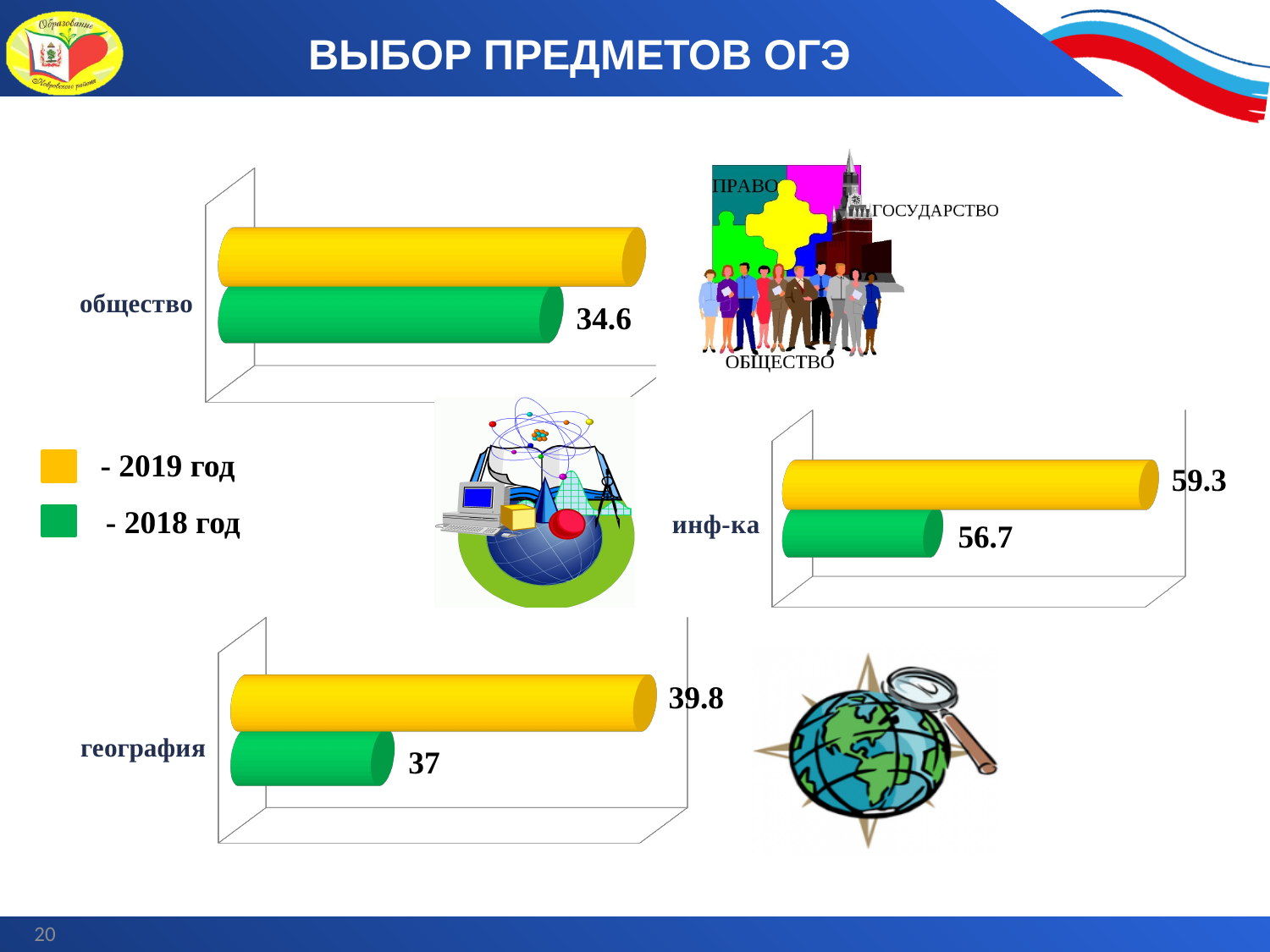
In the chart for общество, which year has the longer bar, 2019 or 2018? 2019 In the chart for география, which year has the larger value, 2019 or 2018? 2019 In the chart for инф-ка, what is the value for 2019? 59.3 In the chart for инф-ка, what is the difference between the 2019 and 2018 values? 2.6 What kind of chart is used for the subjects on this slide? Bar chart How many years does the legend list? 2 In the chart for география, what is the value for 2018? 37 In the chart for общество, what is the value for 2018? 34.6 In the chart for география, what is the value for 2019? 39.8 In the chart for география, what is the difference between the 2019 and 2018 values? 2.8 Which colour represents 2018 in the legend? Green In the chart for инф-ка, what is the value for 2018? 56.7